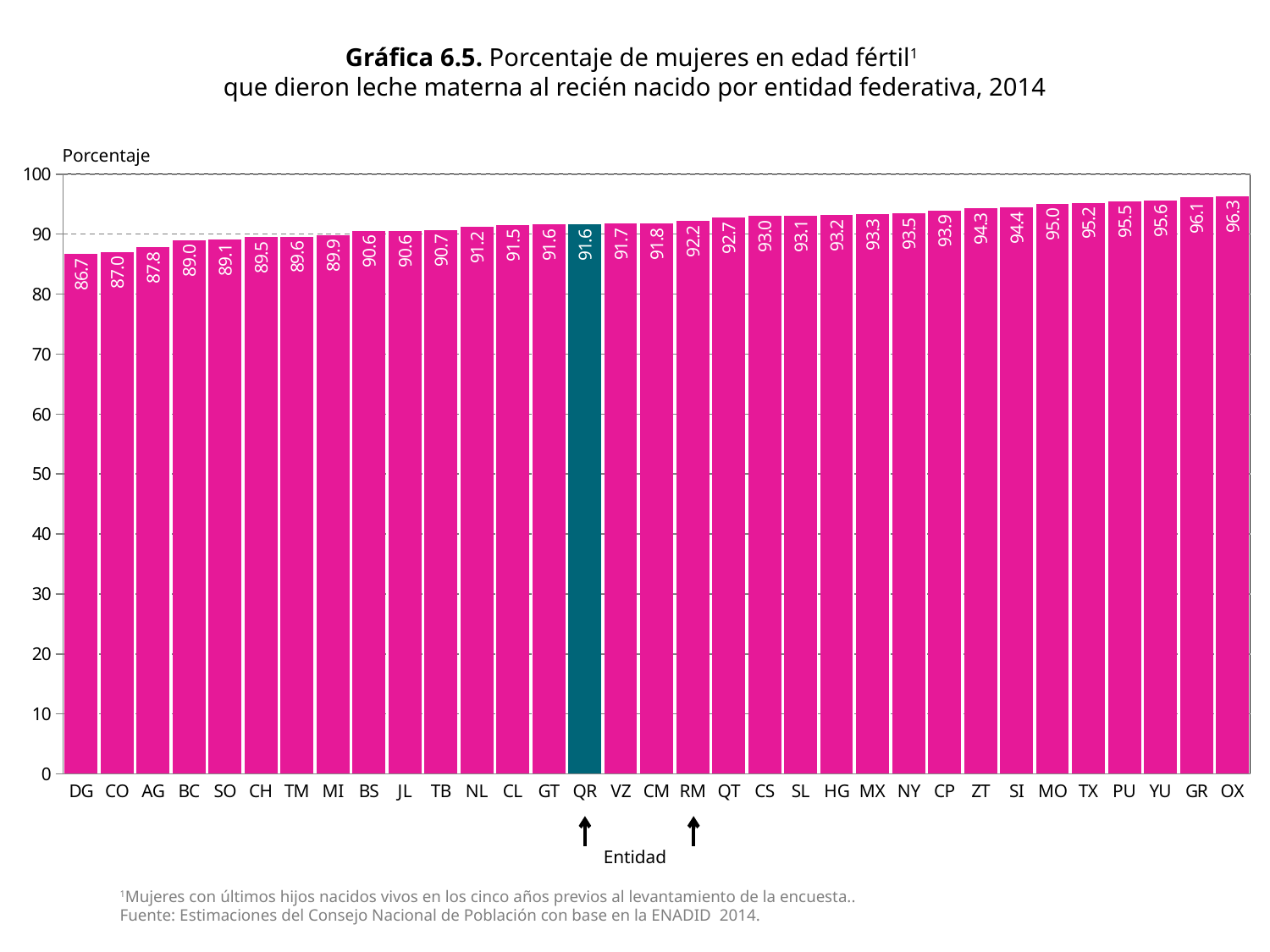
What is the difference between the values for RM and QR? 0.6 Which entity has the highest percentage? OX What kind of chart is this? bar chart What is the value for RM? 92.2 What is the value for OX? 96.3 Which bar is coloured differently (teal) from the rest? QR Is the value for AG greater or less than 90? less What is the difference between the values for OX and DG? 9.6 Which is larger, the value for YU or the value for MO? YU What is the value for QR? 91.6 How many entities are shown on the x axis? 33 Which entity has the lowest percentage? DG